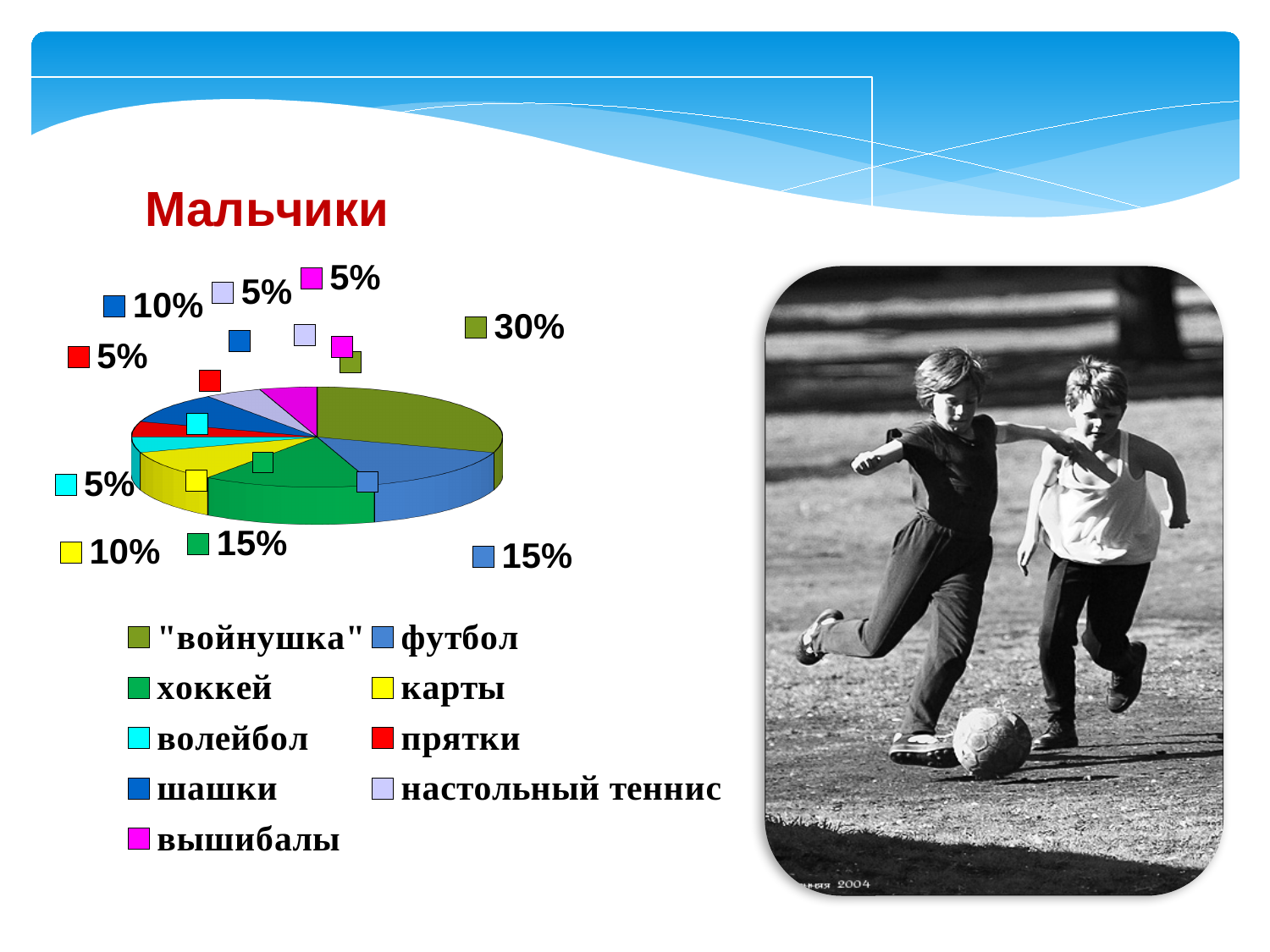
Which colour represents вышибалы in the legend? magenta How many categories does the pie chart have? 9 What is the title of the chart? Мальчики Which category has the largest share of the pie? "войнушка" What share of the pie does "войнушка" have? 30% What is the value for футбол? 15% What kind of chart is shown on the slide? pie chart What is the difference between the shares of "войнушка" and хоккей? 15% What is the value for волейбол? 5% Which is larger, the share for карты or the share for прятки? карты What is the value for карты? 10% What is the value for шашки? 10%